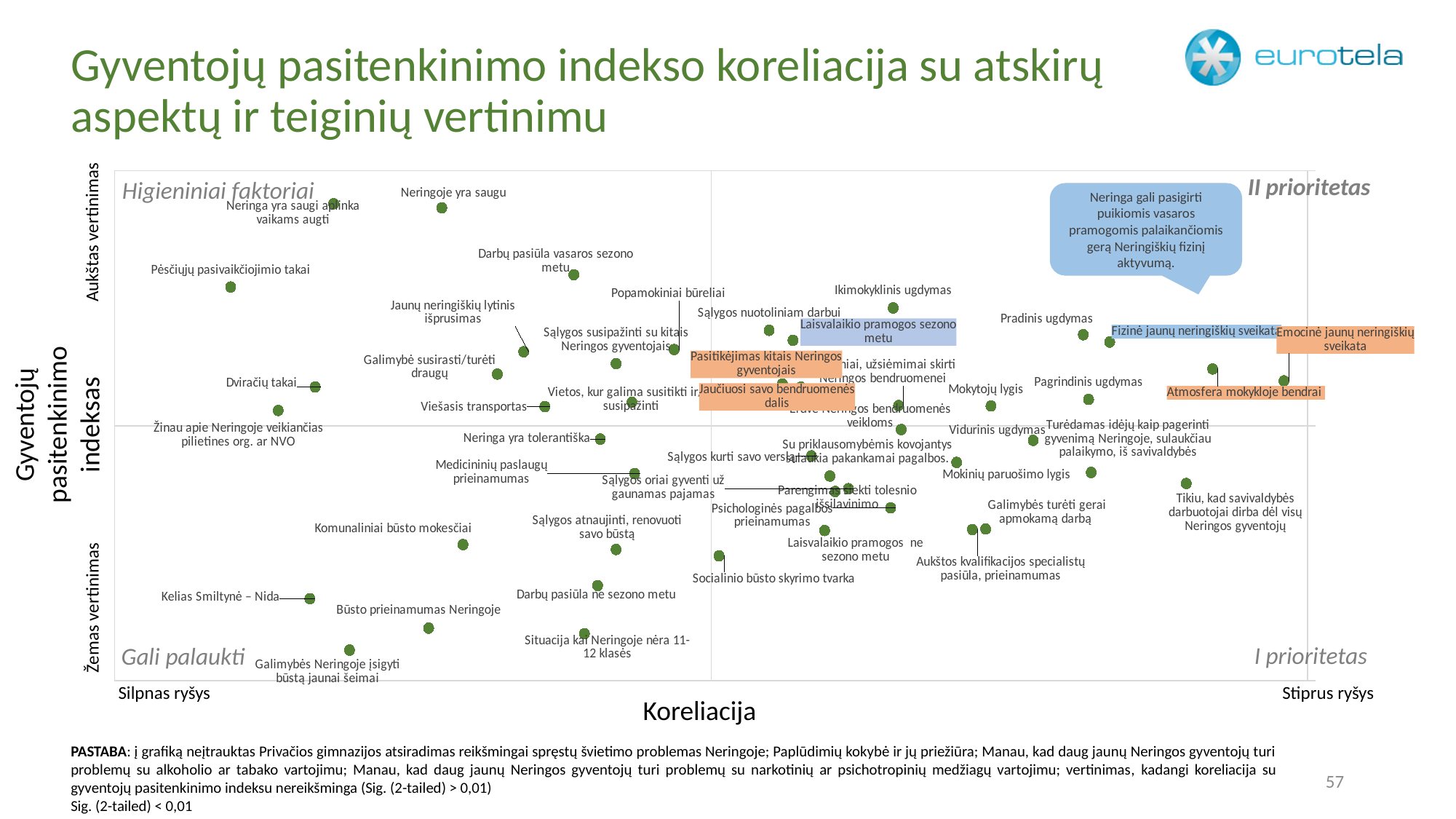
Which is plotted higher on the vertical axis: 'Neringoje yra saugu' or 'Kelias Smiltynė – Nida'? Neringoje yra saugu Which is plotted further right on the Koreliacija axis: 'Dviračių takai' or 'Pradinis ugdymas'? Pradinis ugdymas How many labelled quadrants does the chart have? 4 What is the label of the vertical axis of the chart? Gyventojų pasitenkinimo indeksas What is the label of the horizontal axis of the chart? Koreliacija Which point is plotted furthest to the left on the Koreliacija axis? Pėsčiųjų pasivaikščiojimo takai In which labelled quadrant of the chart does 'Neringoje yra saugu' fall? Higieniniai faktoriai In which labelled quadrant of the chart does 'Socialinio būsto skyrimo tvarka' fall? I prioritetas In which labelled quadrant of the chart does 'Būsto prieinamumas Neringoje' fall? Gali palaukti What kind of chart is shown on the slide? Scatter chart Which point is plotted lowest on the vertical axis (Gyventojų pasitenkinimo indeksas)? Galimybės Neringoje įsigyti būstą jaunai šeimai Which point is plotted furthest to the right on the Koreliacija axis? Emocinė jaunų neringiškių sveikata